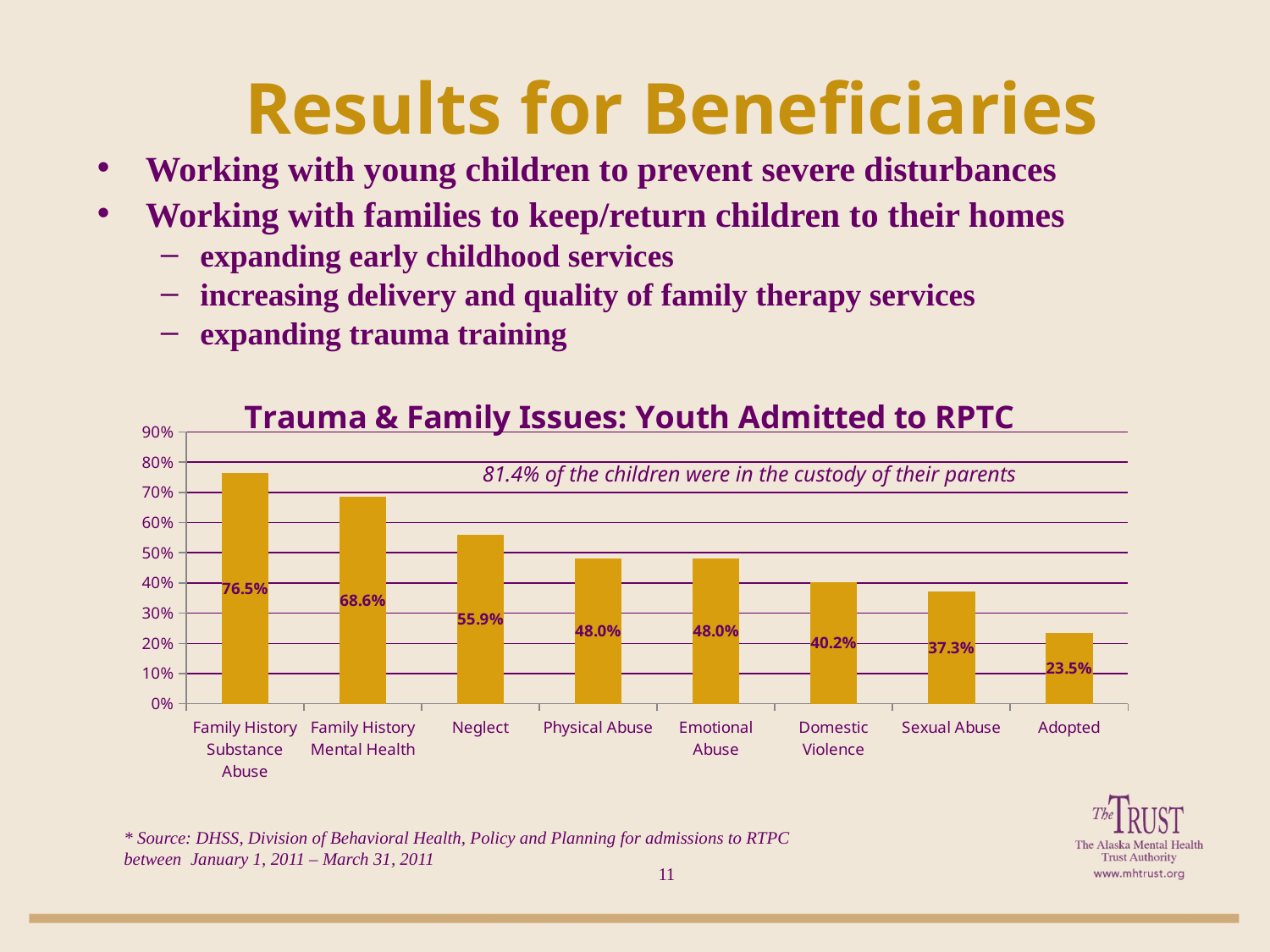
What is the value for Sexual Abuse? 37.3% What is the title of the chart? Trauma & Family Issues: Youth Admitted to RPTC What kind of chart is this? bar chart What is the difference between Family History Substance Abuse and Family History Mental Health? 7.9% Is the value for Neglect greater or less than 50%? greater Do the values generally rise or fall from left to right along the x axis? fall Which category has the highest value? Family History Substance Abuse Which is larger, Domestic Violence or Sexual Abuse? Domestic Violence Which category has the lowest value? Adopted What is the value for Adopted? 23.5% How many categories are shown on the x axis? 8 What is the value for Neglect? 55.9%